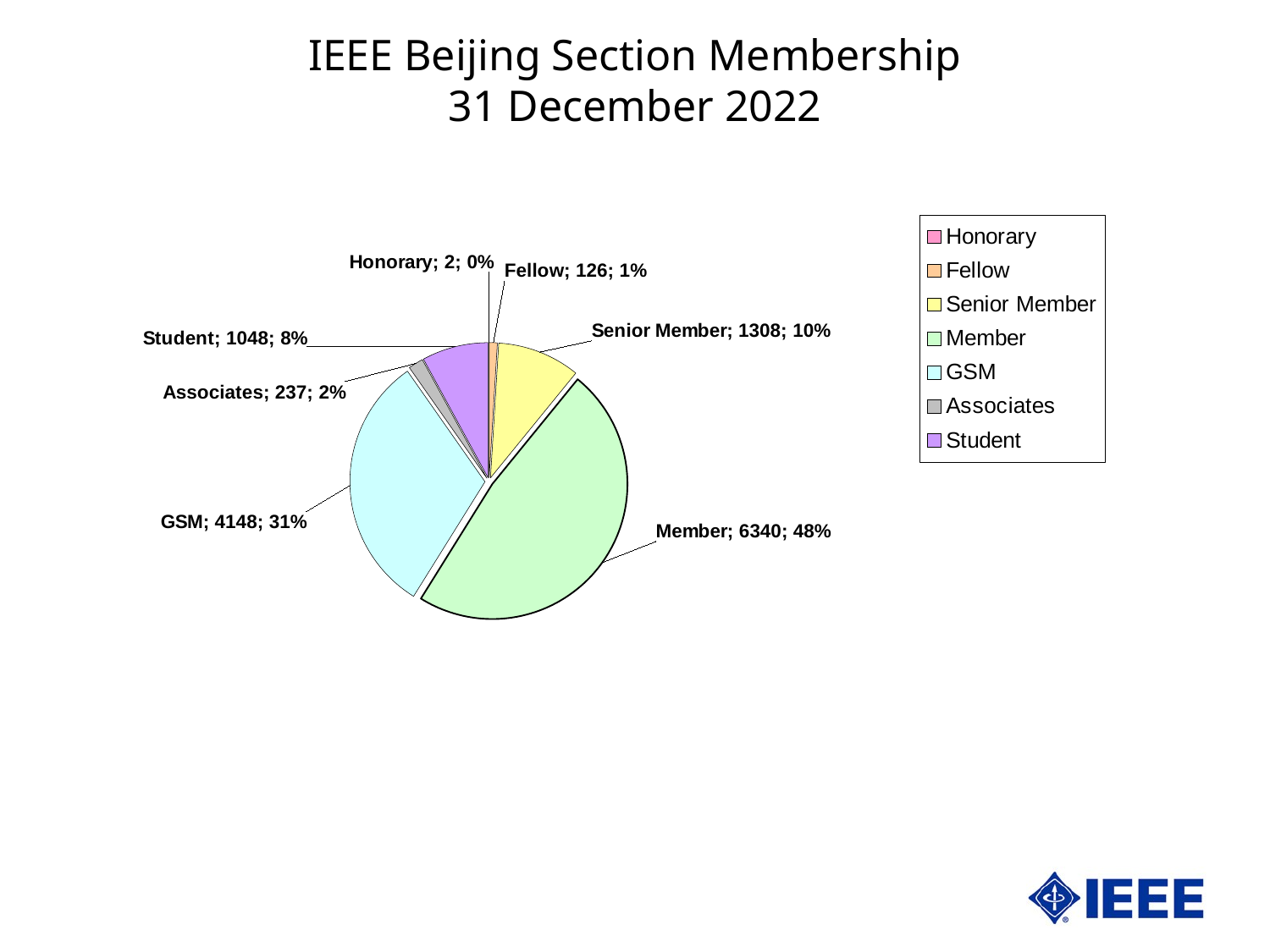
What is the value for GSM? 4148 How many entries does the legend list? 7 How many members are in the Member category? 6340 What share of the pie does Student represent? 8% What share of the pie does Senior Member represent? 10% Which category has the smallest slice? Honorary Which category has the largest slice? Member Which is larger, Fellow or Associates? Associates What is the difference between the Member and GSM values? 2192 How many categories does the pie chart have? 7 What is the title of the chart? IEEE Beijing Section Membership 31 December 2022 What kind of chart is shown on the slide? pie chart